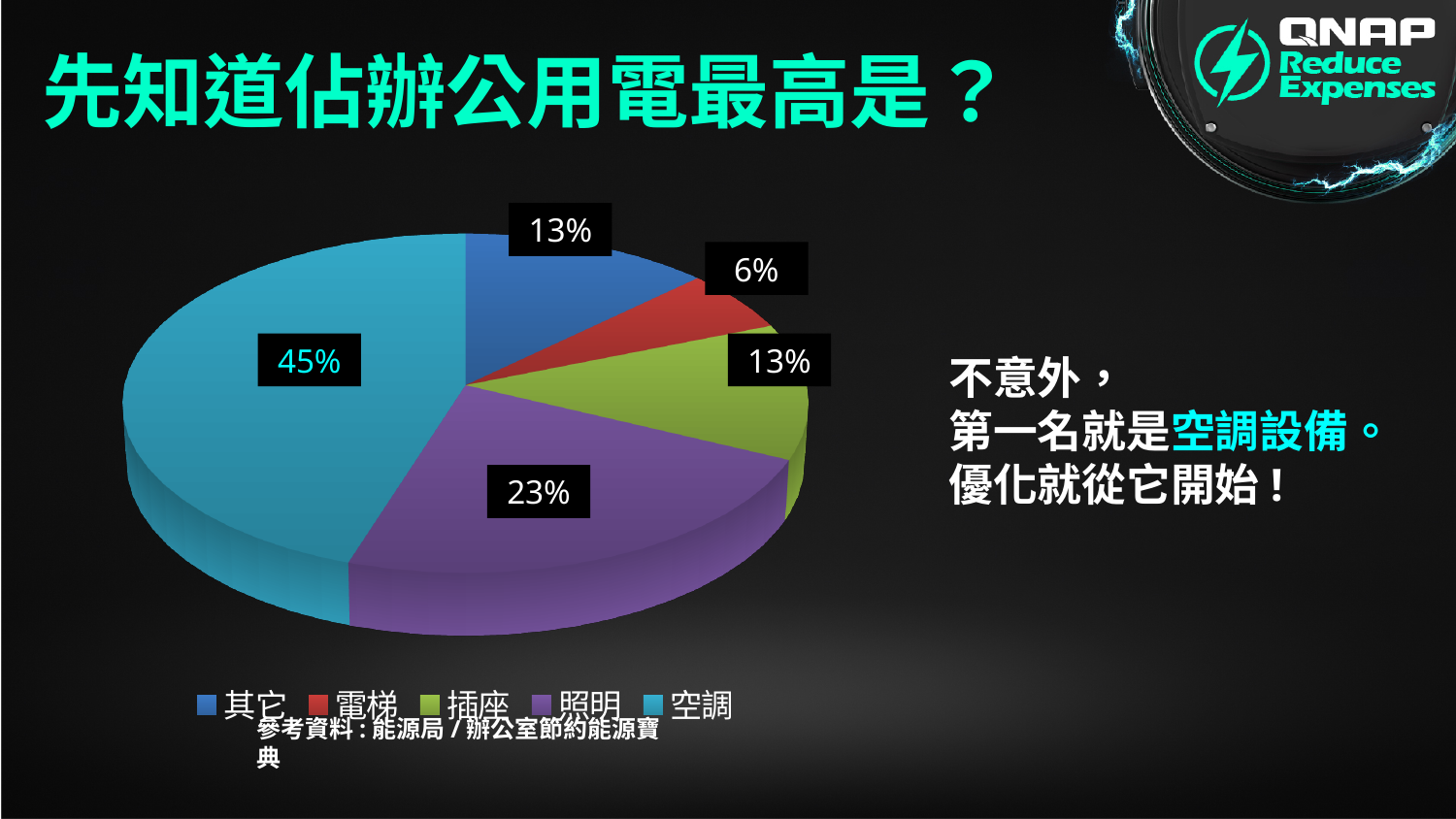
What colour is the 空調 slice in the pie chart? cyan (light blue) Which category has the smallest slice of the pie? 電梯 What share of the pie does 空調 account for? 45% What is the difference between the shares of 插座 and 電梯? 7% What is the value shown for 照明? 23% How many categories does the pie chart have? 5 Which category has the largest slice of the pie? 空調 Which is larger, the share of 照明 or the share of 其它? 照明 What kind of chart is shown on the slide? pie chart What is the value shown for 電梯? 6% What is the difference between the shares of 空調 and 照明? 22% What is the value shown for 插座? 13%